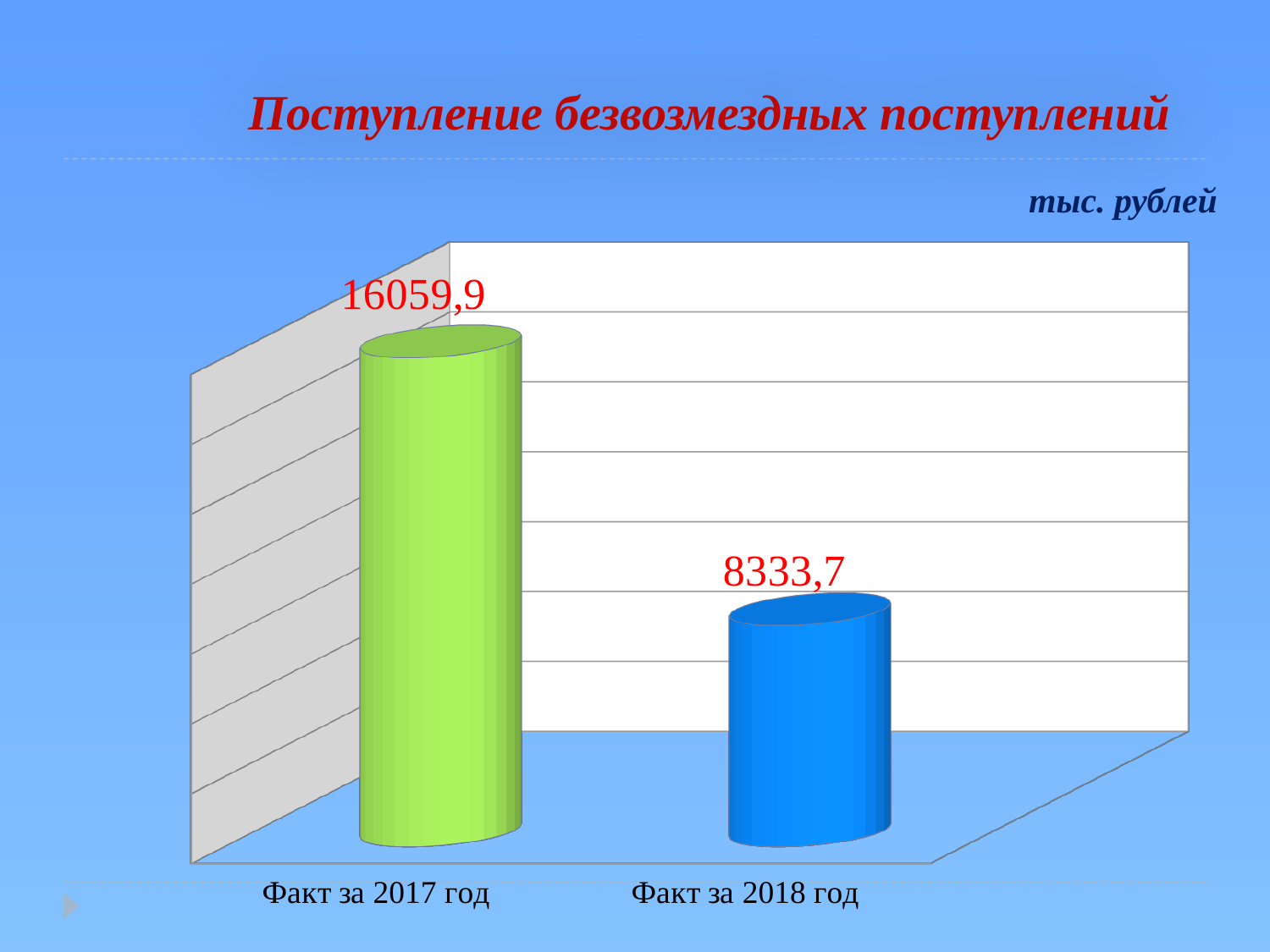
What is the value for Факт за 2018 год? 8333,7 Which is larger, the value for Факт за 2017 год or Факт за 2018 год? Факт за 2017 год Do the values rise or fall from Факт за 2017 год to Факт за 2018 год? fall What is the difference between the values for Факт за 2017 год and Факт за 2018 год? 7726,2 What is the value for Факт за 2017 год? 16059,9 What kind of chart is shown on the slide? bar chart Which category has the lowest value? Факт за 2018 год In what units are the values shown, according to the slide? тыс. рублей How many categories are shown in the chart? 2 What is the title of the chart? Поступление безвозмездных поступлений Which category has the highest value? Факт за 2017 год